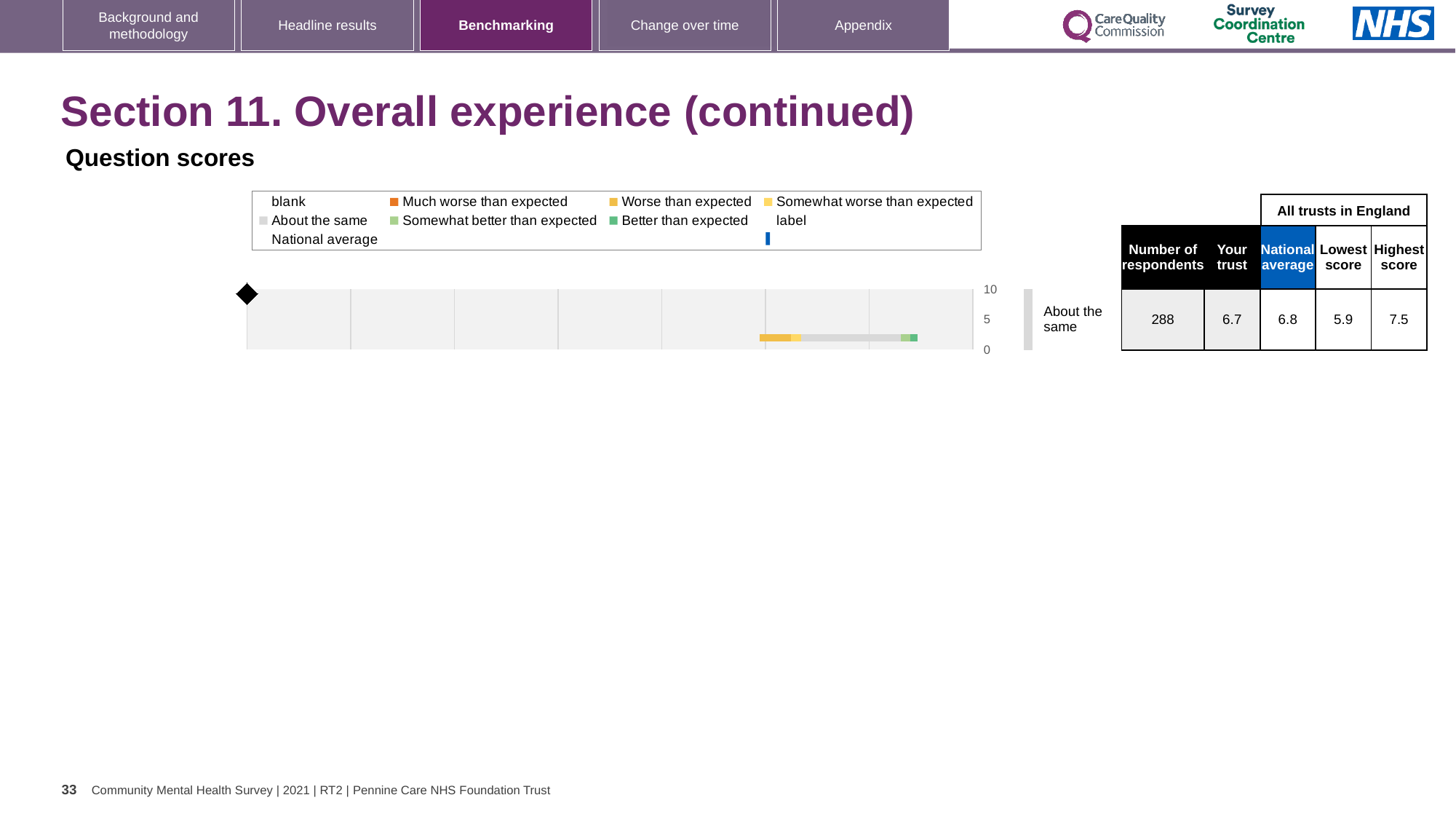
What is the difference between the Highest score and the Lowest score shown on the slide? 1.6 How many question bars are plotted in the Question scores chart? 1 What is the maximum value shown on the score axis of the Question scores chart? 10 What is the difference between the National average and the 'Your trust' score? 0.1 What is the 'Your trust' score shown for the question in the Question scores chart? 6.7 What is the Highest score among all trusts in England shown on the slide? 7.5 How many respondents are shown for the question in the Question scores chart? 288 Which is larger, the 'Your trust' score or the National average? National average What is the Lowest score among all trusts in England shown on the slide? 5.9 What is the National average score shown in the Question scores chart? 6.8 What benchmark category label is shown next to the bar in the Question scores chart? About the same What kind of chart is used in the Question scores section? Bar chart